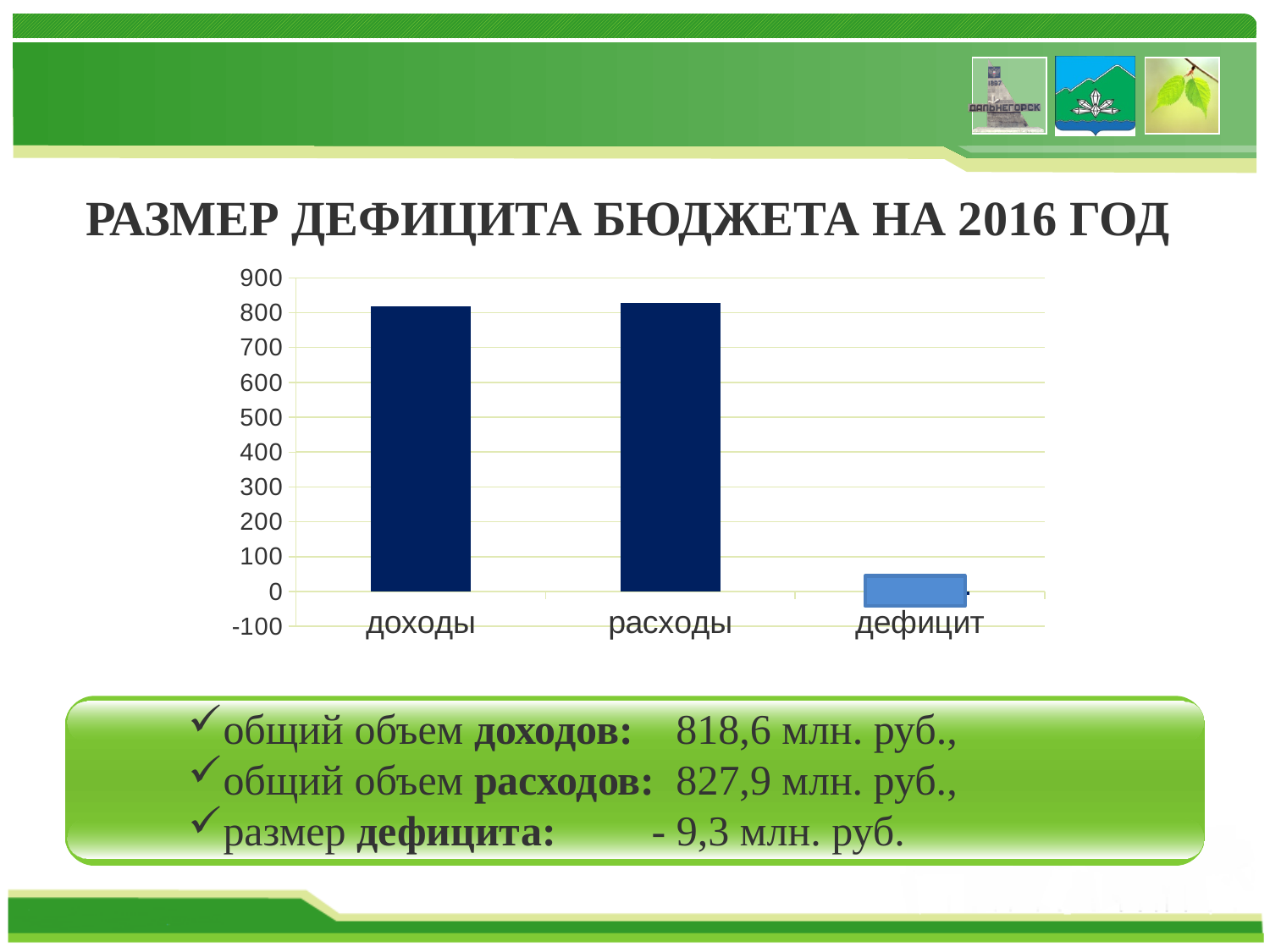
Which category has the highest bar in the chart? расходы Which category has the lowest value in the chart? дефицит Is the value for доходы greater or less than 700? greater What is the difference between расходы and доходы? 9,3 млн. руб. Is the value for дефицит greater or less than 100? less What type of chart is shown on the slide? bar chart What is the title of the slide's chart? РАЗМЕР ДЕФИЦИТА БЮДЖЕТА НА 2016 ГОД How many categories are shown on the x axis of the chart? 3 Which is larger, доходы or расходы? расходы What is the value for расходы, as stated on the slide? 827,9 млн. руб. What is the value for доходы, as stated on the slide? 818,6 млн. руб. What is the size of the дефицит, as stated on the slide? - 9,3 млн. руб.